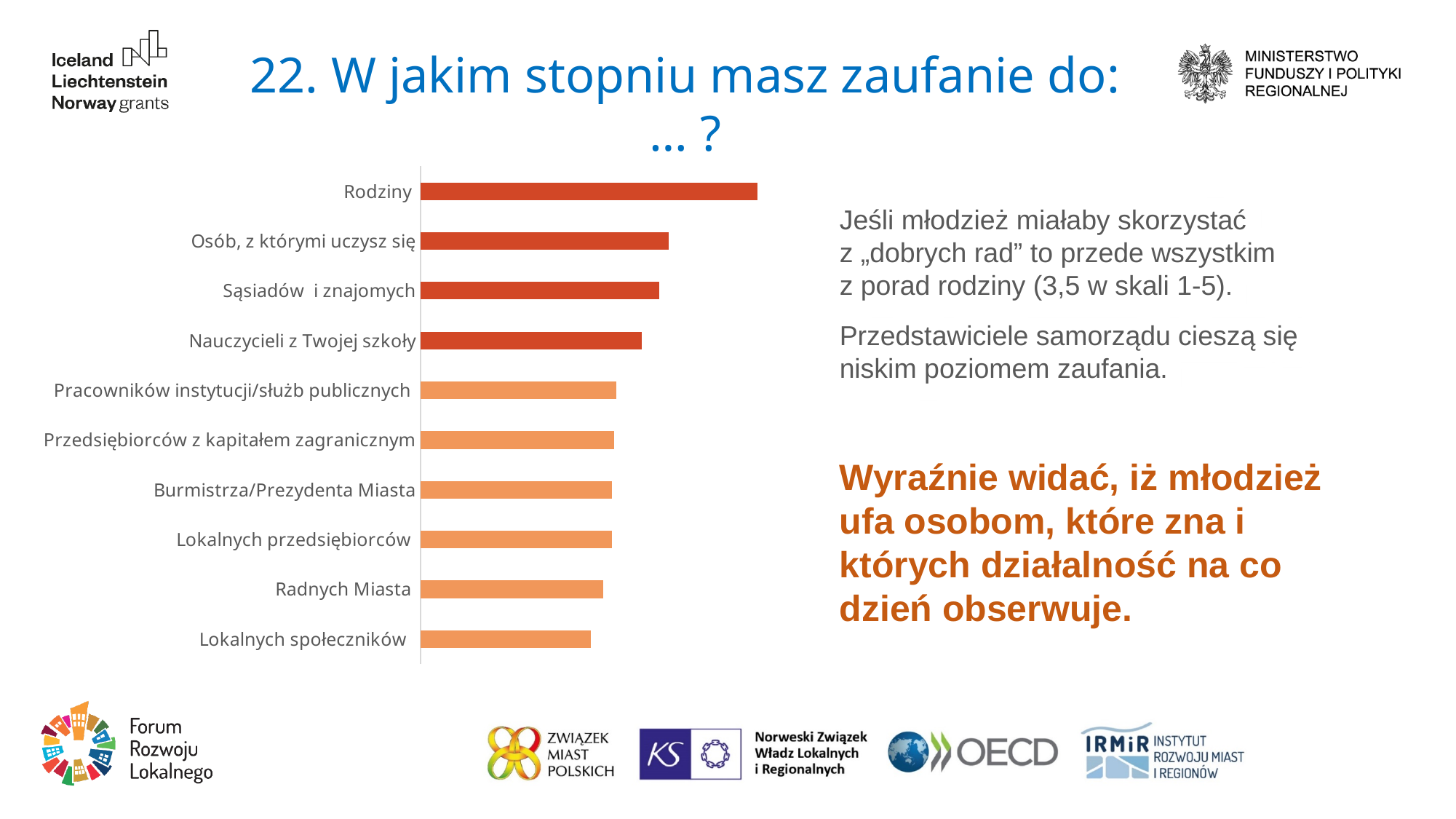
Which bar is longer: Rodziny or Radnych Miasta? Rodziny Which bar is longer: Rodziny or Nauczycieli z Twojej szkoły? Rodziny Which category is listed at the top of the bar chart? Rodziny How many categories does the bar chart show? 10 How many bars in the chart are drawn in the darker red colour? 4 Which category has the shortest bar in the chart? Lokalnych społeczników Which category has the longest bar in the chart? Rodziny Which bar is longer: Osób, z którymi uczysz się or Burmistrza/Prezydenta Miasta? Osób, z którymi uczysz się What kind of chart is shown on the slide? bar chart